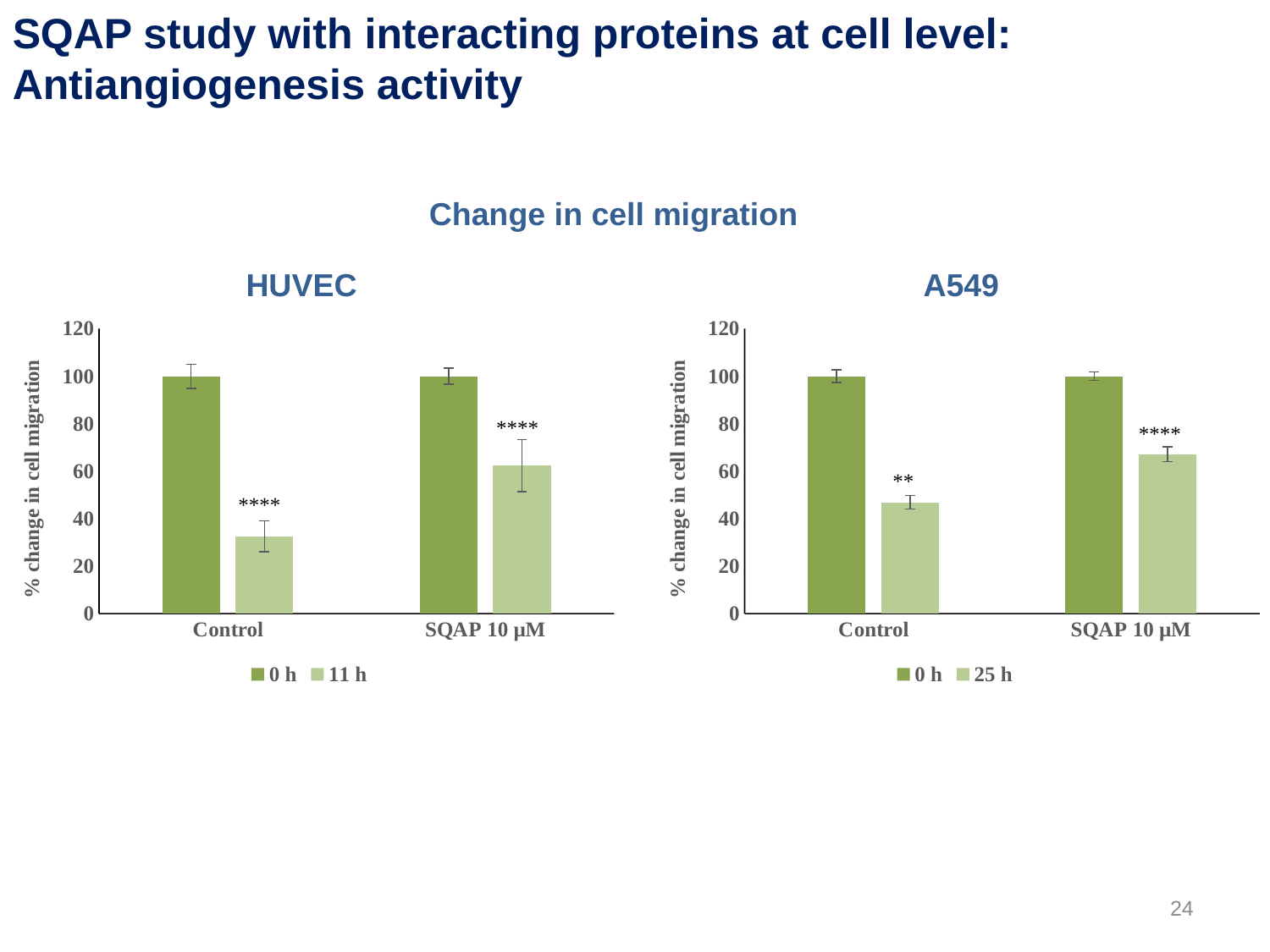
In the HUVEC chart, what kind of chart is shown? bar chart In the HUVEC chart, what is the value for Control at 0 h? 100 In the A549 chart, which category has the lowest bar? Control (25 h) In the HUVEC chart, is the value for SQAP 10 µM at 11 h greater or less than 40? greater In the A549 chart, what are the two series named in the legend? 0 h and 25 h In the A549 chart, is the value for Control at 25 h greater or less than 60? less In the A549 chart, what is the value for SQAP 10 µM at 0 h? 100 In the HUVEC chart, which is larger for the 11 h series: Control or SQAP 10 µM? SQAP 10 µM In the HUVEC chart, how many series does the legend list? 2 In the HUVEC chart, how many categories are shown on the x axis? 2 In the HUVEC chart, is the value for Control at 11 h greater or less than 40? less